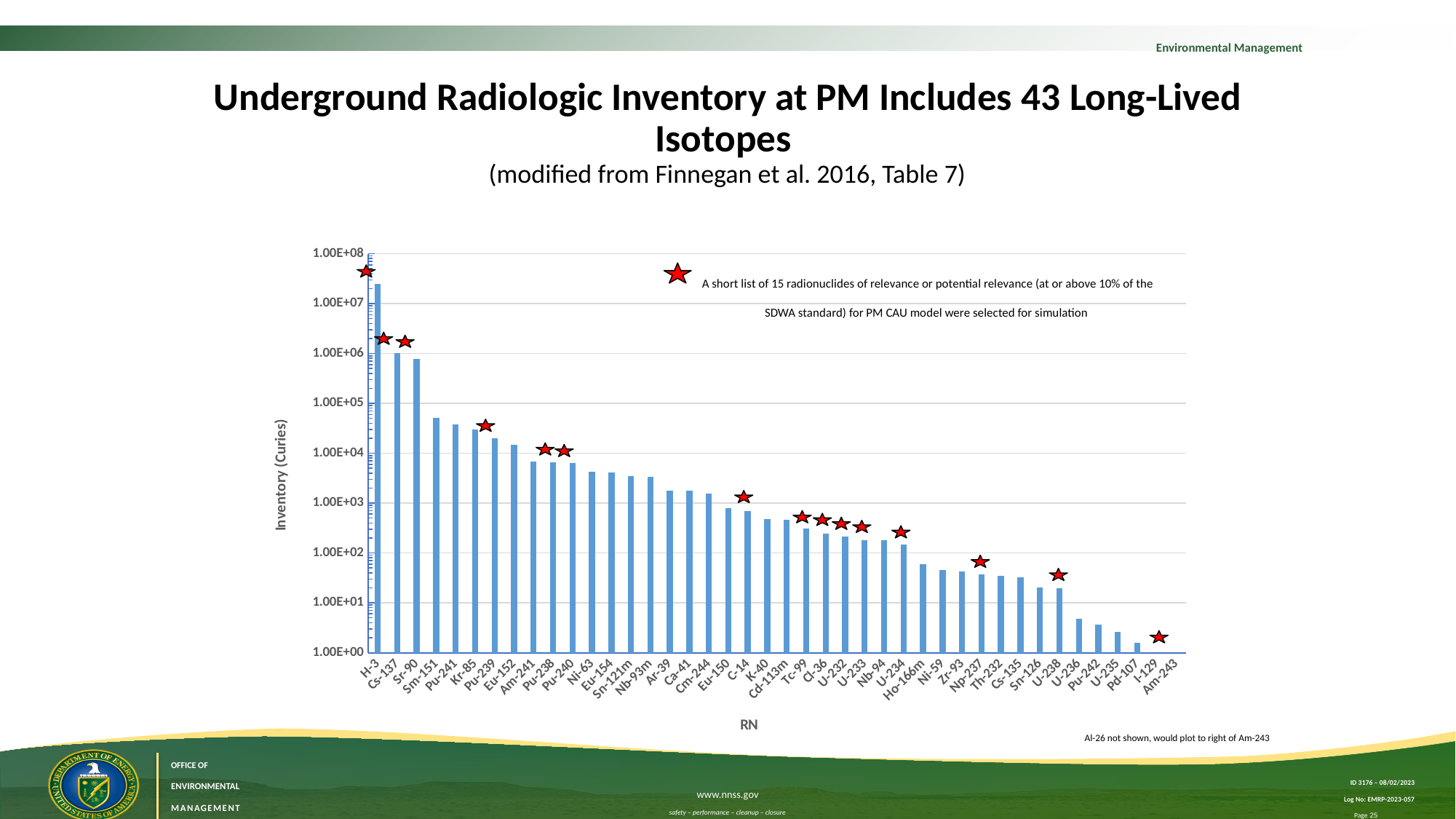
Do the bar values rise or fall moving from left to right along the x axis? fall Which radionuclide has the lowest inventory shown in the chart? Am-243 Which has the larger inventory, Pu-239 or Eu-152? Pu-239 What kind of chart is shown on the slide? bar chart What is the title of the vertical axis of the chart? Inventory (Curies) Which has the larger inventory, Cs-137 or Sr-90? Cs-137 Is the inventory for U-236 greater or less than 1.00E+01 Curies? less Is the inventory for Ar-39 greater or less than 1.00E+03 Curies? greater Is the inventory for Sr-90 greater or less than 1.00E+06 Curies? less Which radionuclide has the highest inventory in the chart? H-3